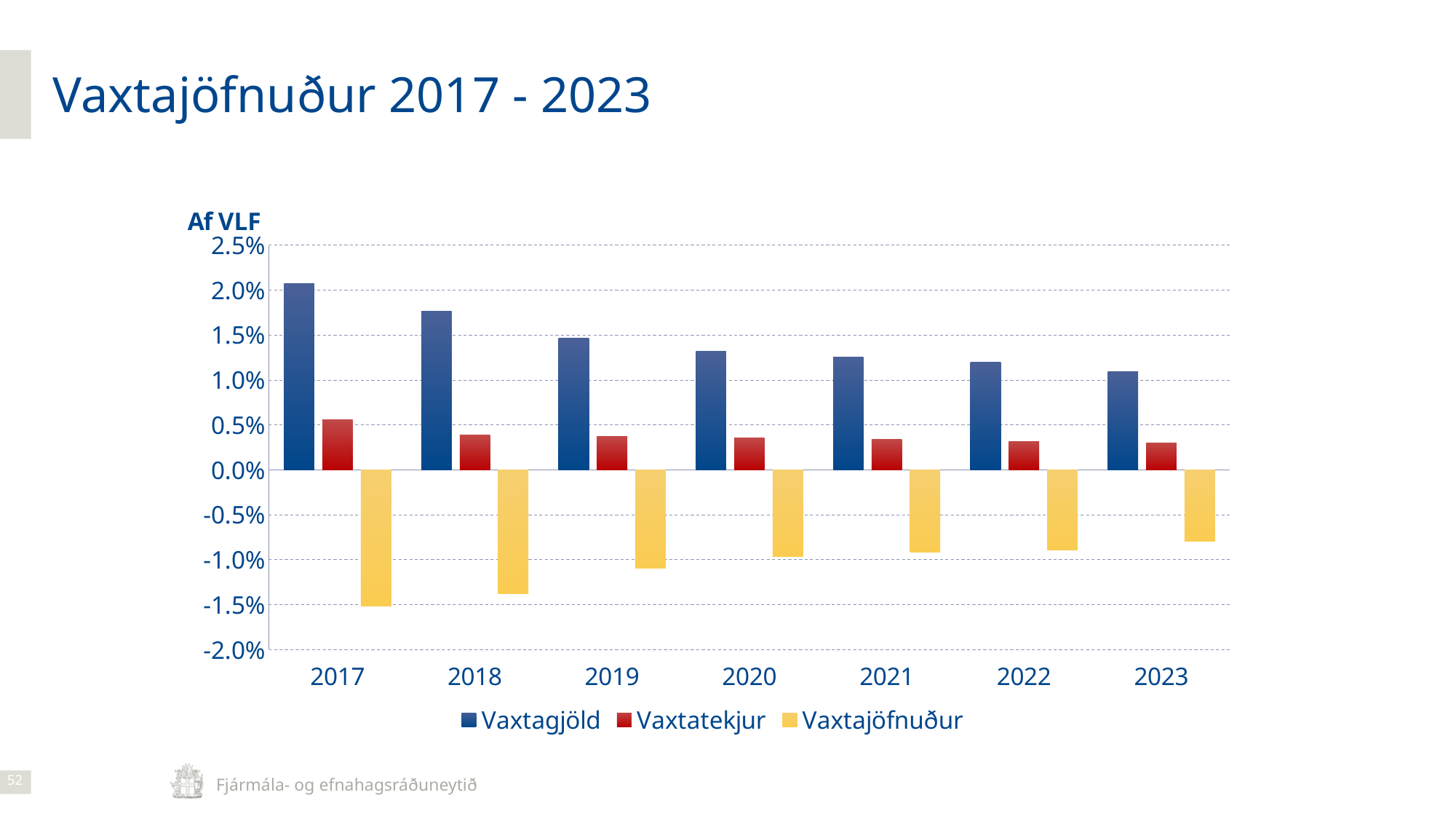
Is the value for Vaxtajöfnuður in 2023 greater or less than -1.0%? greater In which year is Vaxtagjöld lowest? 2023 Which is larger in 2017, Vaxtagjöld or Vaxtatekjur? Vaxtagjöld What label is shown above the vertical axis? Af VLF Is the value for Vaxtatekjur in 2018 greater or less than 0.5%? less What kind of chart is shown on the slide? bar chart In which year is Vaxtagjöld highest? 2017 Is the value for Vaxtagjöld in 2018 greater or less than 1.5%? greater How many series does the legend list? 3 In which year is Vaxtajöfnuður most negative? 2017 Do the Vaxtagjöld values rise or fall from 2017 to 2023? fall How many years are shown on the x axis? 7